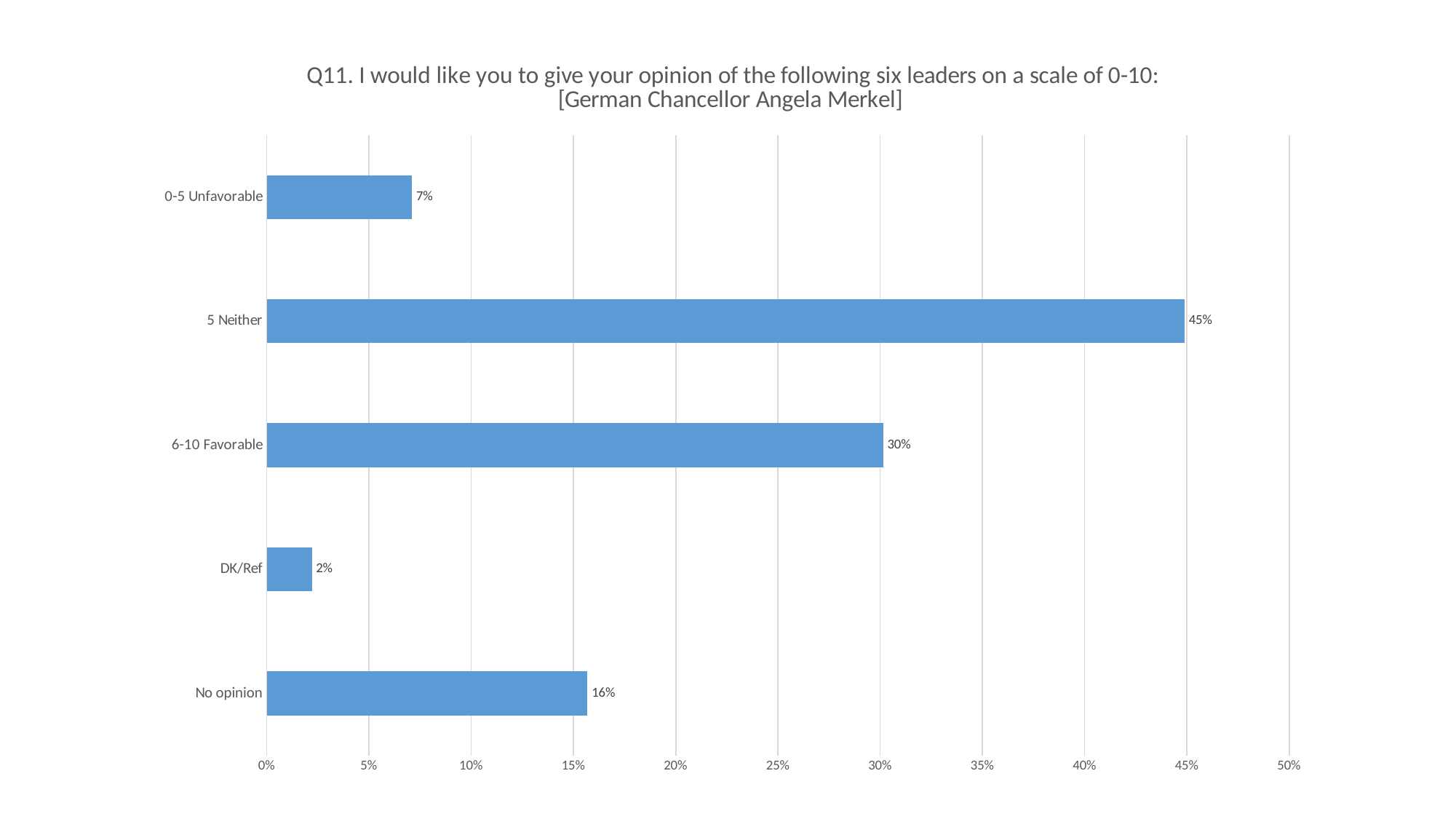
What is the difference between '5 Neither' and '6-10 Favorable'? 15% Which category has the highest value? 5 Neither What kind of chart is shown on the slide? bar chart How many categories are shown in the chart? 5 Which leader is the chart about? German Chancellor Angela Merkel What is the value for 'No opinion'? 16% Which is larger, 'No opinion' or '0-5 Unfavorable'? No opinion What is the value for '0-5 Unfavorable'? 7% Is the value for '6-10 Favorable' greater or less than 25%? greater What percentage of respondents gave a '5 Neither' rating for Angela Merkel? 45% Which category has the lowest value? DK/Ref What is the value for '6-10 Favorable'? 30%